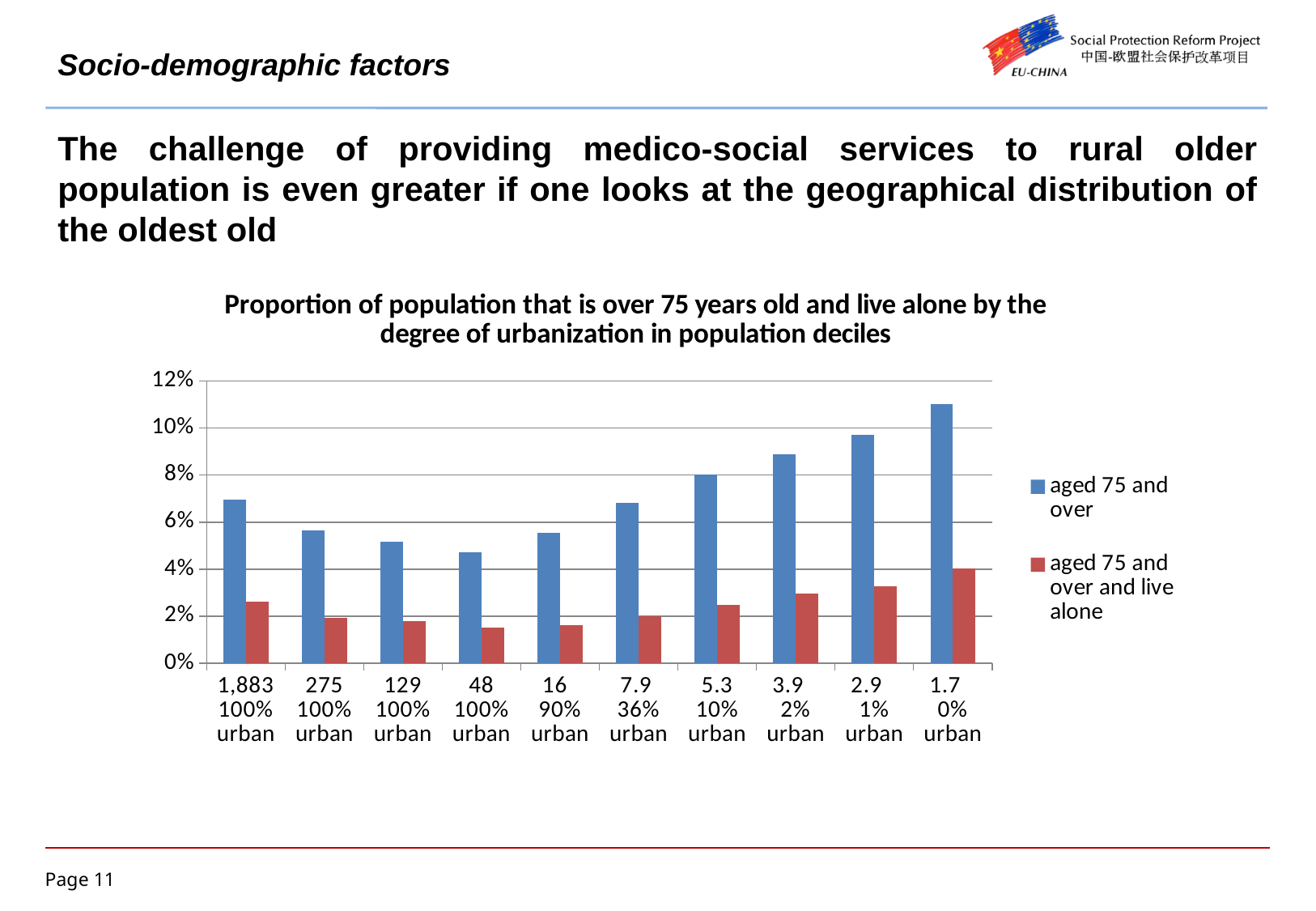
Which category has the highest value for 'aged 75 and over and live alone'? 1.7 0% urban Is the 'aged 75 and over' value for 48 100% urban greater or less than 6%? less Which category has the highest value for 'aged 75 and over'? 1.7 0% urban How many population decile categories are shown along the x axis? 10 Which is larger: the 'aged 75 and over' value for 1,883 100% urban or for 275 100% urban? 1,883 100% urban What colour are the bars for 'aged 75 and over and live alone'? red What kind of chart is shown on the slide? bar chart Is the 'aged 75 and over and live alone' value for 1,883 100% urban greater or less than 2%? greater How many series does the chart legend list? 2 Is the 'aged 75 and over' value for 1.7 0% urban greater or less than 10%? greater From 16 90% urban to 1.7 0% urban, do the 'aged 75 and over' values rise or fall? rise Which category has the lowest value for 'aged 75 and over'? 48 100% urban